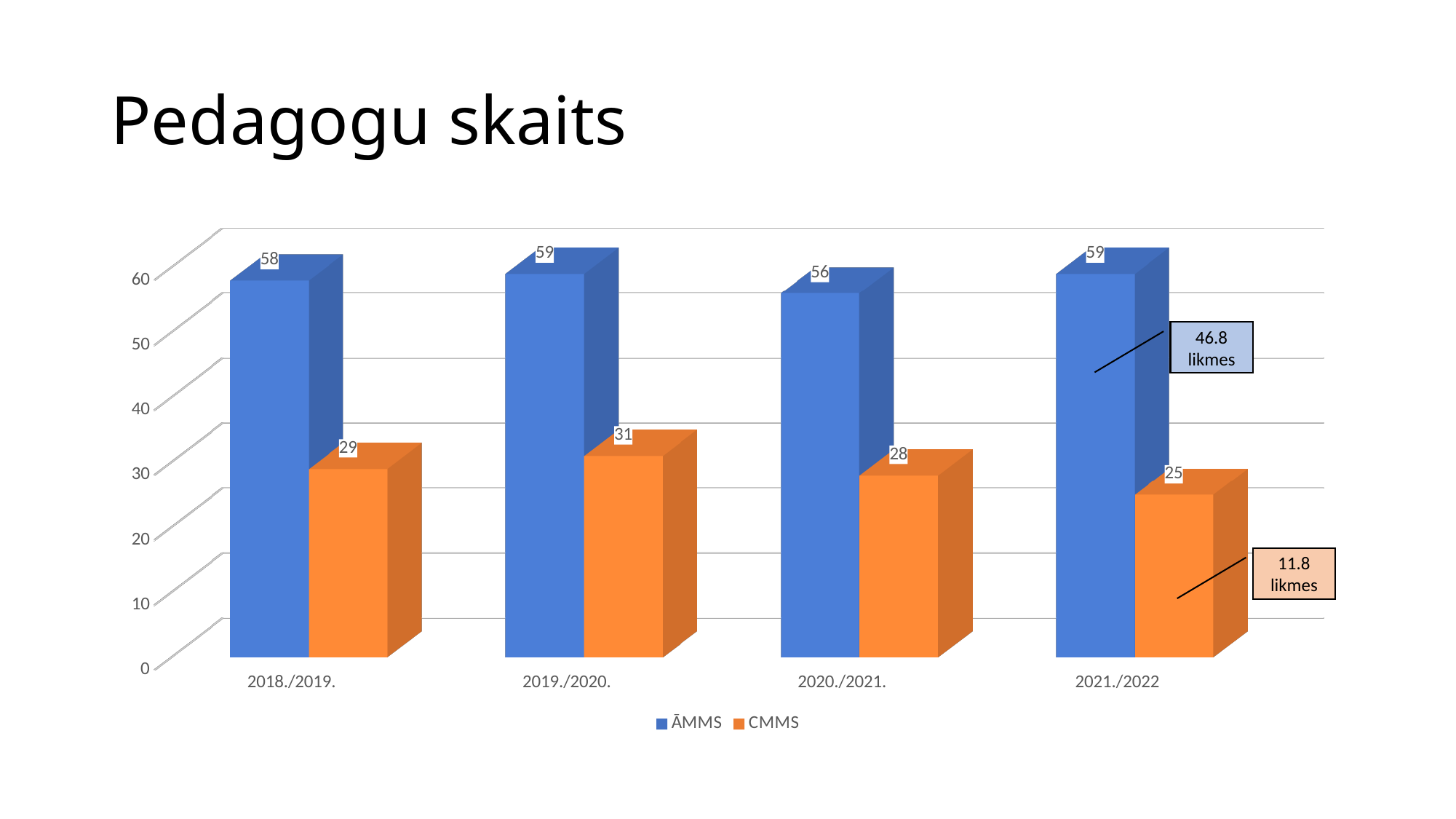
In which school year is the ĀMMS value lowest? 2020./2021. Which is larger, the CMMS value in 2018./2019. or in 2021./2022? 2018./2019. What is the value for CMMS in 2021./2022? 25 How many series does the legend list? 2 In which school year is the CMMS value highest? 2019./2020. What is the title of the slide? Pedagogu skaits What is the value for ĀMMS in 2018./2019.? 58 What is the difference between the ĀMMS and CMMS values in 2020./2021.? 28 How many school years are shown on the x axis? 4 What kind of chart is shown on the slide? Bar chart What is the value for CMMS in 2019./2020.? 31 In which school year is the CMMS value lowest? 2021./2022